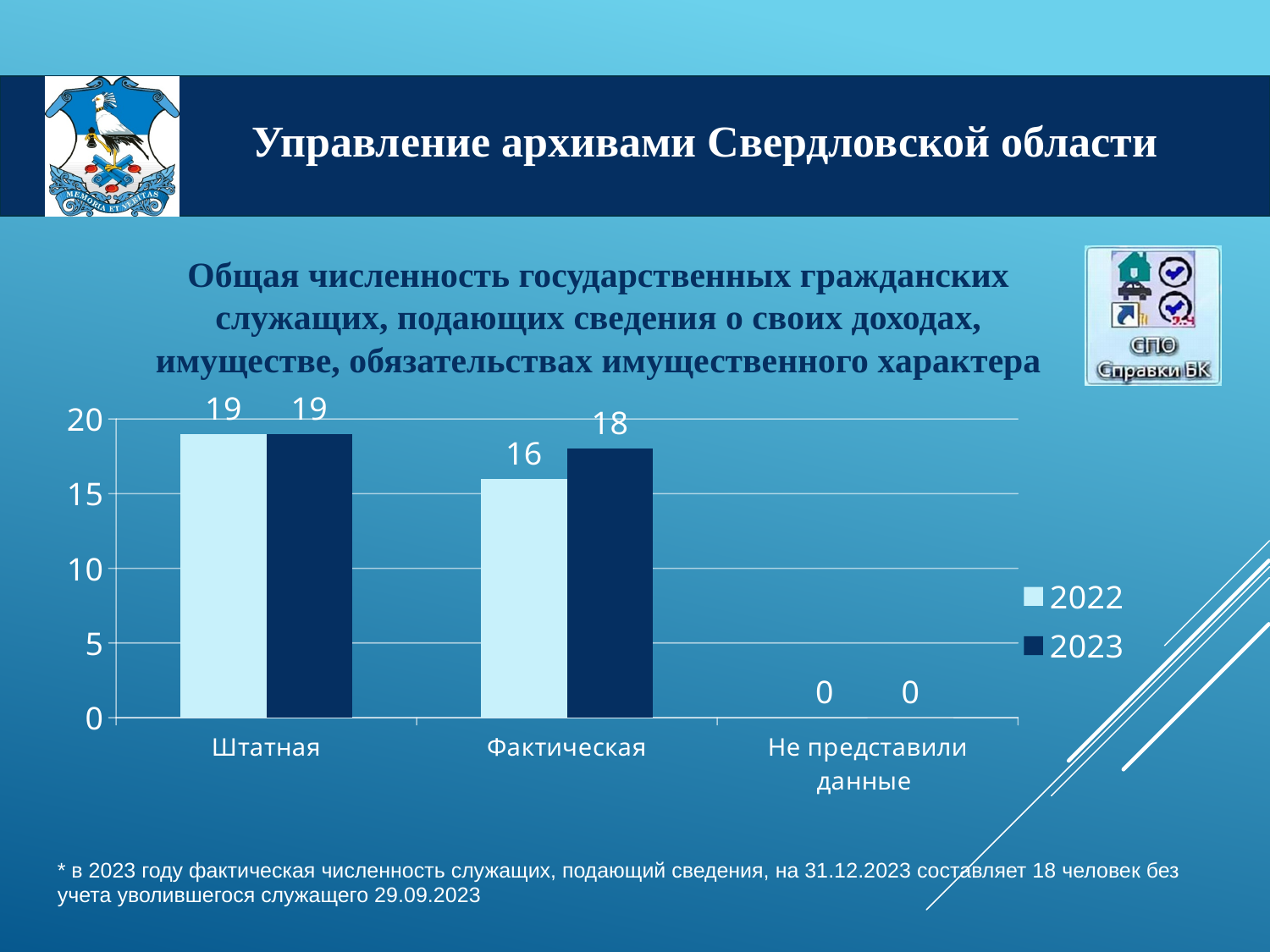
What is the value for Не представили данные in 2023? 0 What is the value for Штатная in 2022? 19 Which is larger for Фактическая: the 2022 value or the 2023 value? 2023 How many series does the legend list? 2 How many categories are shown on the x axis? 3 What is the value for Фактическая in 2023? 18 Which series is shown in dark blue in the legend? 2023 What kind of chart is shown on the slide? bar chart Which category has the lowest value for 2022? Не представили данные Which category has the highest value for 2023? Штатная What is the value for Фактическая in 2022? 16 What is the difference between the 2023 and 2022 values for Фактическая? 2